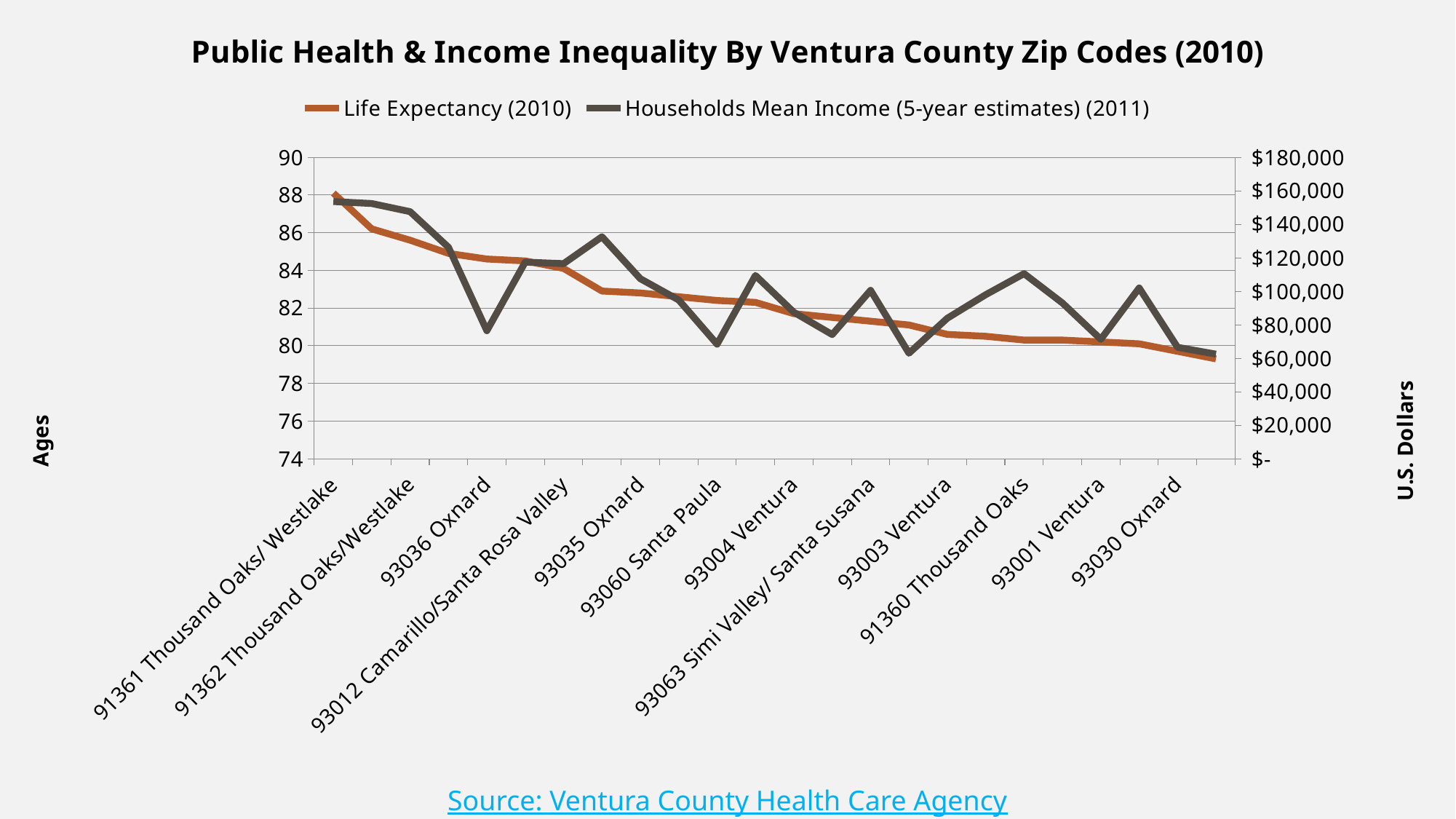
What is the label of the right-hand vertical axis? U.S. Dollars What is the title of the chart? Public Health & Income Inequality By Ventura County Zip Codes (2010) How many series does the legend list? 2 Is the Households Mean Income value for 93035 Oxnard greater or less than $120,000? less Which has the higher Households Mean Income, 93035 Oxnard or 93036 Oxnard? 93035 Oxnard Does Life Expectancy (2010) generally rise or fall moving left to right along the x axis? Fall Which zip code has the highest Life Expectancy (2010)? 91361 Thousand Oaks/ Westlake What kind of chart is shown on the slide? Line chart Is the Households Mean Income value for 93060 Santa Paula greater or less than $80,000? less